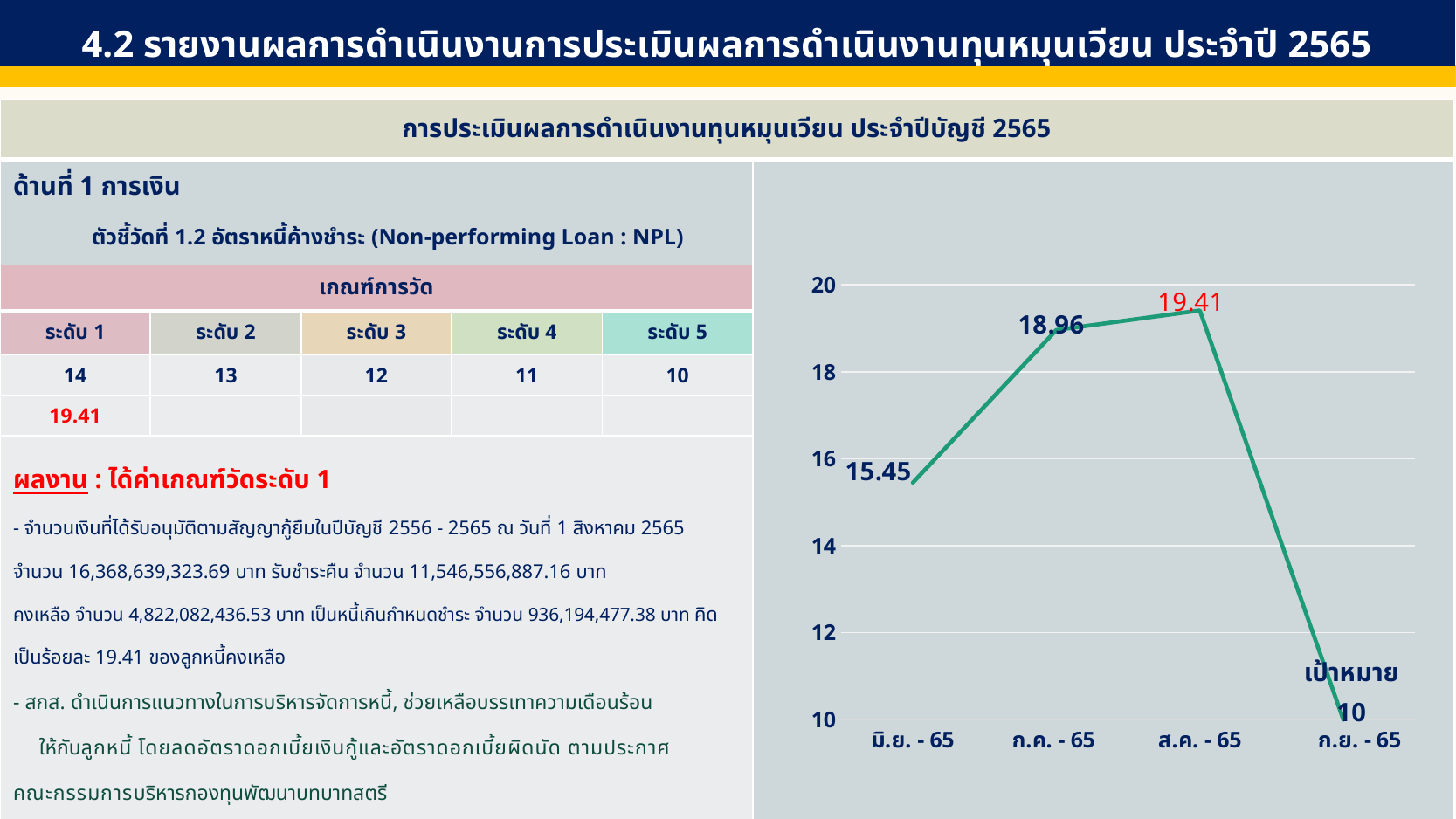
What is the value plotted for ก.ค. - 65? 18.96 What label is shown next to the last point on the line chart? เป้าหมาย 10 Which month has the lowest value on the line chart? ก.ย. - 65 What is the difference between the values for ก.ค. - 65 and มิ.ย. - 65? 3.51 Which is larger, the value for มิ.ย. - 65 or the value for ก.ค. - 65? ก.ค. - 65 What is the value plotted for ก.ย. - 65? 10 What is the value plotted for มิ.ย. - 65? 15.45 What is the difference between the values for ส.ค. - 65 and ก.ค. - 65? 0.45 What is the value plotted for ส.ค. - 65? 19.41 Which month has the highest value on the line chart? ส.ค. - 65 How many data points are plotted on the line chart? 4 What type of chart is shown on the right side of the slide? line chart